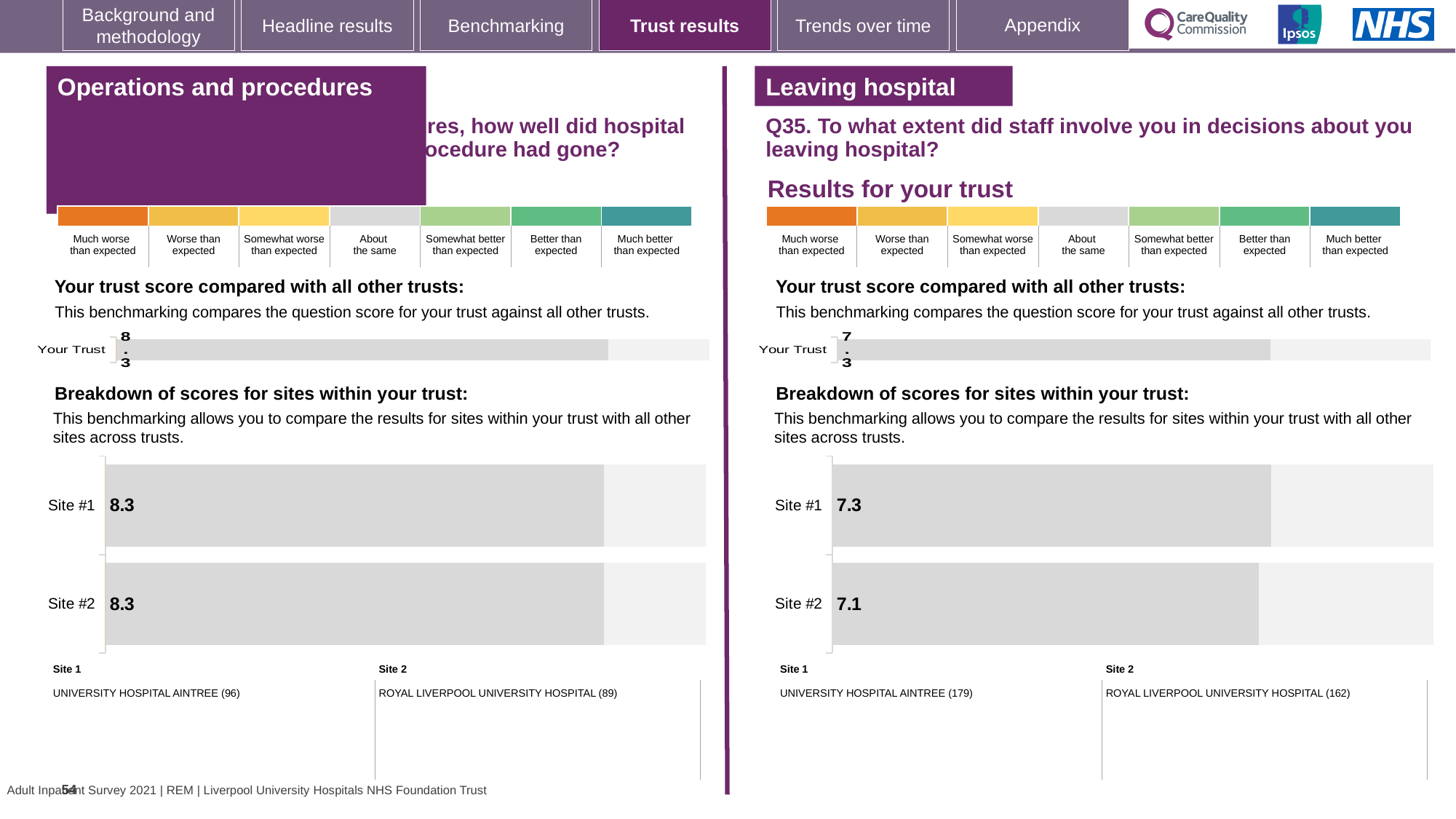
In the 'Leaving hospital' site breakdown chart on the right, which site has the higher score? Site #1 In the 'Operations and procedures' site breakdown chart on the left, what is the score for Site #2? 8.3 In the 'Operations and procedures' trust score chart on the left, what is the score shown for Your Trust? 8.3 What type of chart is used for the site breakdown on the right-hand 'Leaving hospital' section? Bar chart In the 'Leaving hospital' trust score chart on the right, what is the score shown for Your Trust? 7.3 How many sites are shown in the 'Operations and procedures' site breakdown chart on the left? 2 In the 'Leaving hospital' site breakdown chart on the right, what is the difference between the Site #1 and Site #2 scores? 0.2 Is the Site #1 score in the 'Operations and procedures' chart on the left larger than the Site #1 score in the 'Leaving hospital' chart on the right? Yes In the 'Leaving hospital' site breakdown chart on the right, which site has the lowest score? Site #2 In the 'Operations and procedures' site breakdown chart on the left, what is the score for Site #1? 8.3 In the 'Leaving hospital' site breakdown chart on the right, what is the score for Site #1? 7.3 In the 'Leaving hospital' site breakdown chart on the right, what is the score for Site #2? 7.1